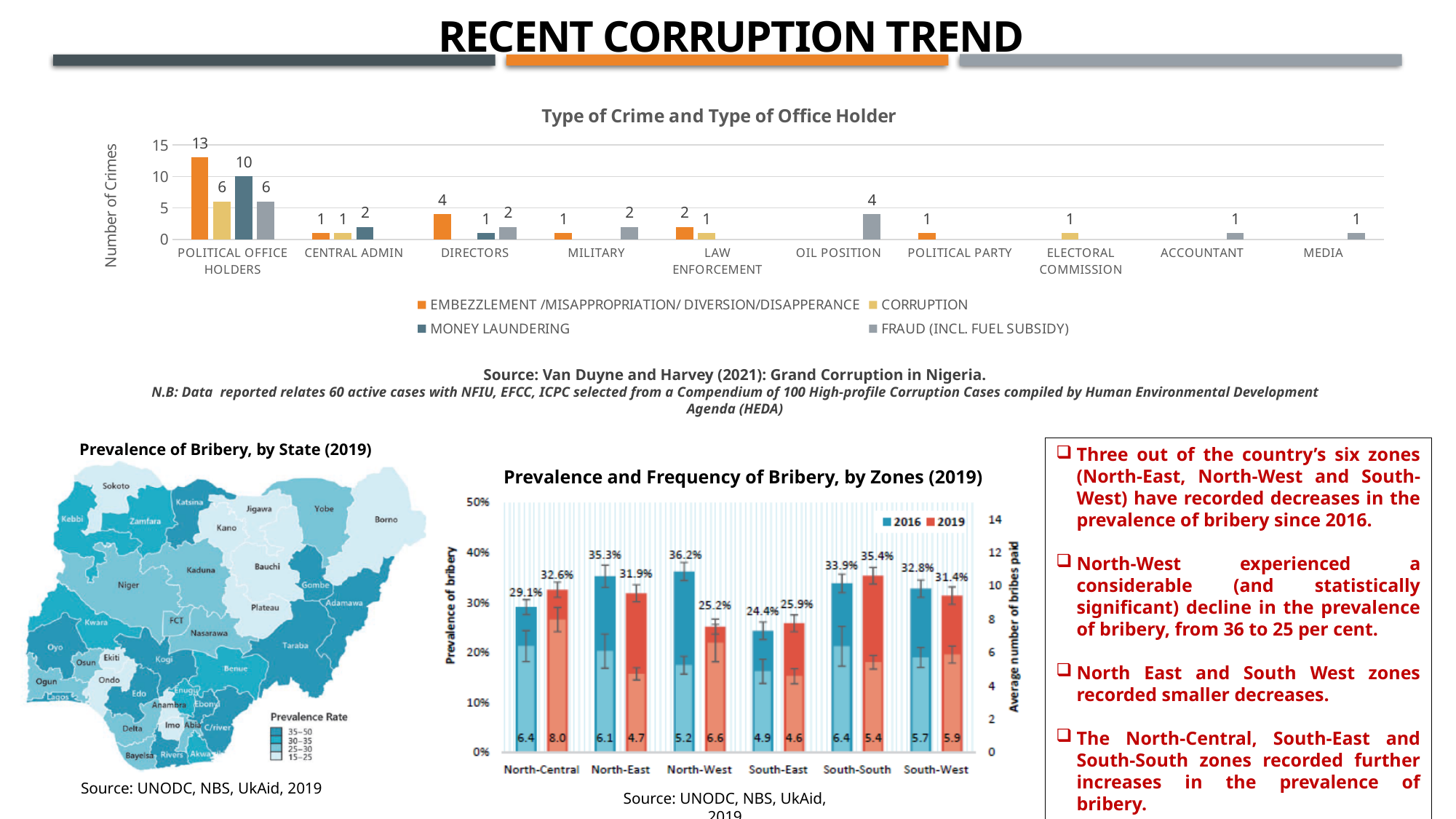
In the 'Prevalence and Frequency of Bribery, by Zones (2019)' chart, what was the average number of bribes paid in North-Central in 2019? 8.0 In the 'Type of Crime and Type of Office Holder' chart, what is the difference between the embezzlement count for Political Office Holders and the embezzlement count for Directors? 9 In the 'Type of Crime and Type of Office Holder' chart, how many office holder categories are shown on the x axis? 10 In the 'Prevalence and Frequency of Bribery, by Zones (2019)' chart, what was the prevalence of bribery in North-West in 2019? 25.2% In the 'Prevalence and Frequency of Bribery, by Zones (2019)' chart, what is the difference between the 2016 and 2019 prevalence of bribery in North-West? 11.0% In the 'Type of Crime and Type of Office Holder' chart, how many series does the legend list? 4 In the 'Type of Crime and Type of Office Holder' chart, how many money laundering crimes are recorded for Political Office Holders? 10 In the 'Type of Crime and Type of Office Holder' chart, how many embezzlement/misappropriation/diversion/disappearance crimes are recorded for Political Office Holders? 13 In the 'Type of Crime and Type of Office Holder' chart, how many fraud (incl. fuel subsidy) crimes are recorded for Oil Position? 4 In the 'Prevalence and Frequency of Bribery, by Zones (2019)' chart, which zone had the highest prevalence of bribery in 2016? North-West In the 'Type of Crime and Type of Office Holder' chart, which office holder category has the highest number of crimes for any single crime type? Political Office Holders What kind of chart is 'Prevalence and Frequency of Bribery, by Zones (2019)'? Bar chart